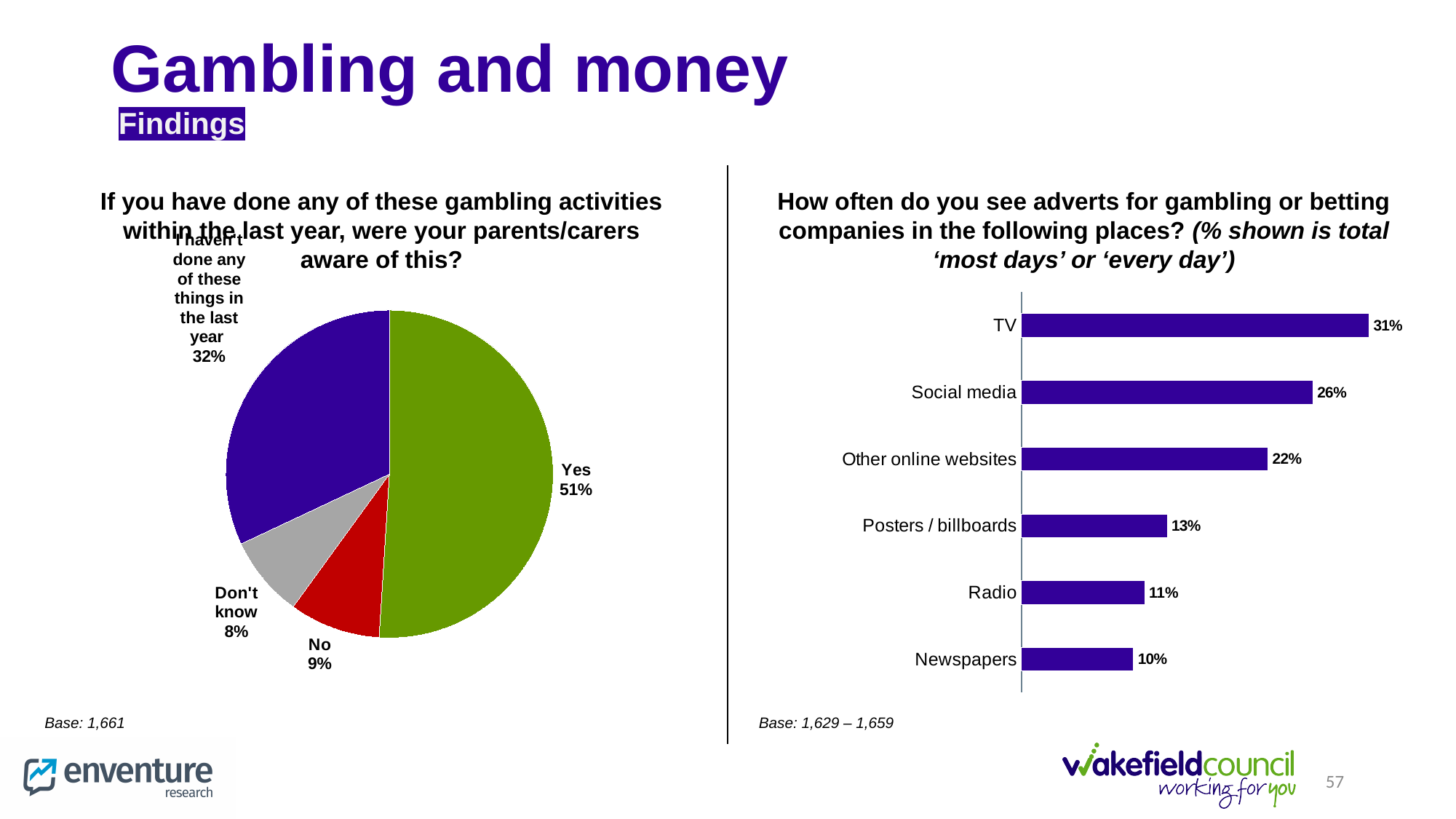
In the bar chart on the right, which place has the highest value? TV In the pie chart on the left, what percentage answered 'Yes'? 51% In the bar chart on the right, how many places are listed? 6 In the bar chart on the right, what is the difference between TV and Other online websites? 9% In the bar chart on the right, what is the value for Social media? 26% In the bar chart on the right, which place has the lowest value? Newspapers In the pie chart on the left, which response has the smallest share? Don't know In the bar chart on the right, what is the value for Radio? 11% In the pie chart on the left, how many slices are there? 4 What type of chart is shown on the right side of the slide? Bar chart In the pie chart on the left, what is the difference between the 'Yes' share and the 'No' share? 42% In the pie chart on the left, what percentage answered 'Don't know'? 8%